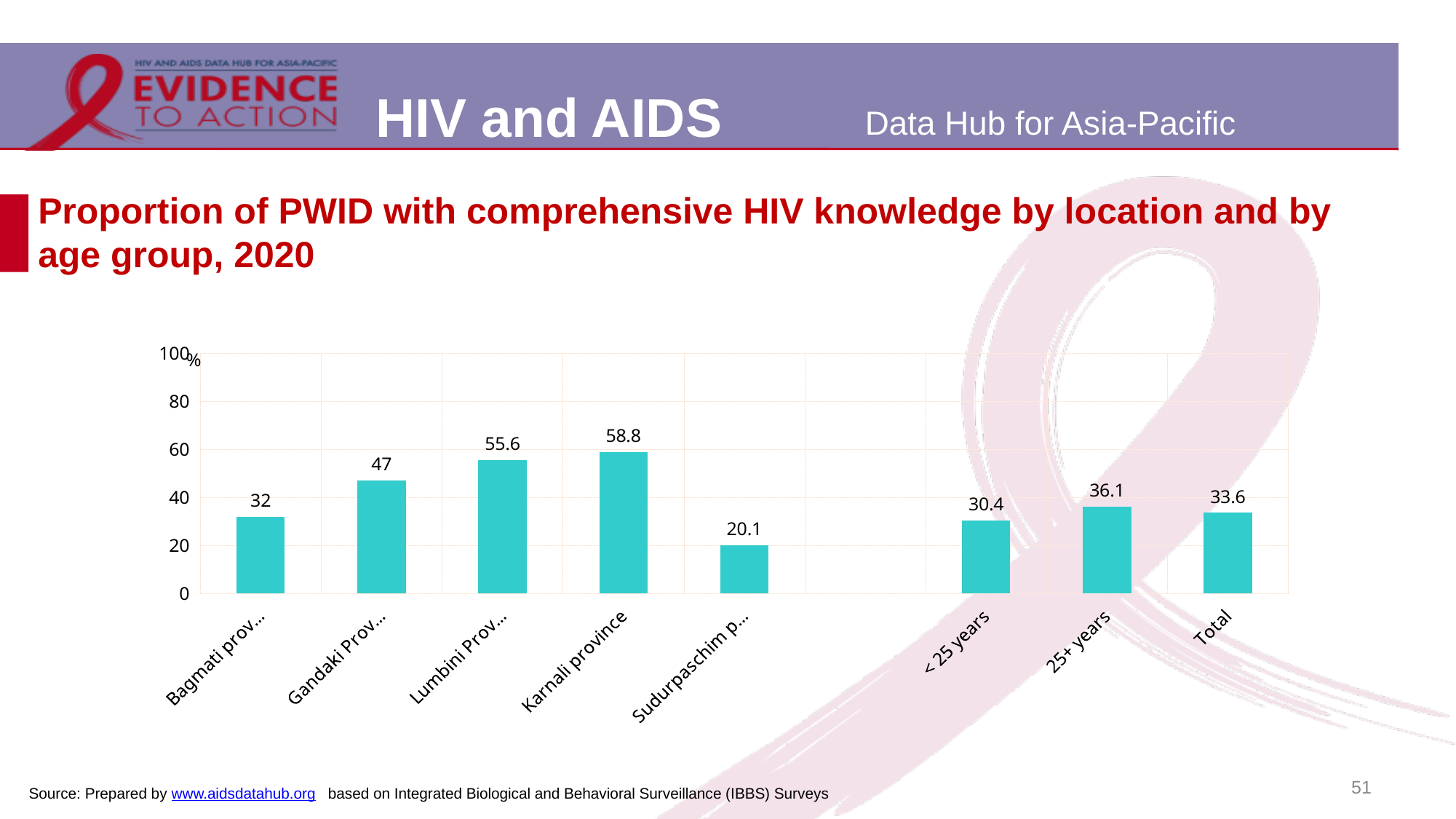
How many bars are plotted in the chart? 8 Which is larger, the value for Gandaki province or the value for Lumbini province? Lumbini province What is the difference between the values for Karnali province and Sudurpaschim province? 38.7 What is the value for the < 25 years age group? 30.4 What is the value for Total? 33.6 Is the value for Bagmati province greater or less than 40? less What is the value for the 25+ years age group? 36.1 Which category has the highest value? Karnali province What is the difference between the values for 25+ years and < 25 years? 5.7 What kind of chart is shown on the slide? Bar chart What is the value for Karnali province? 58.8 Which category has the lowest value? Sudurpaschim province